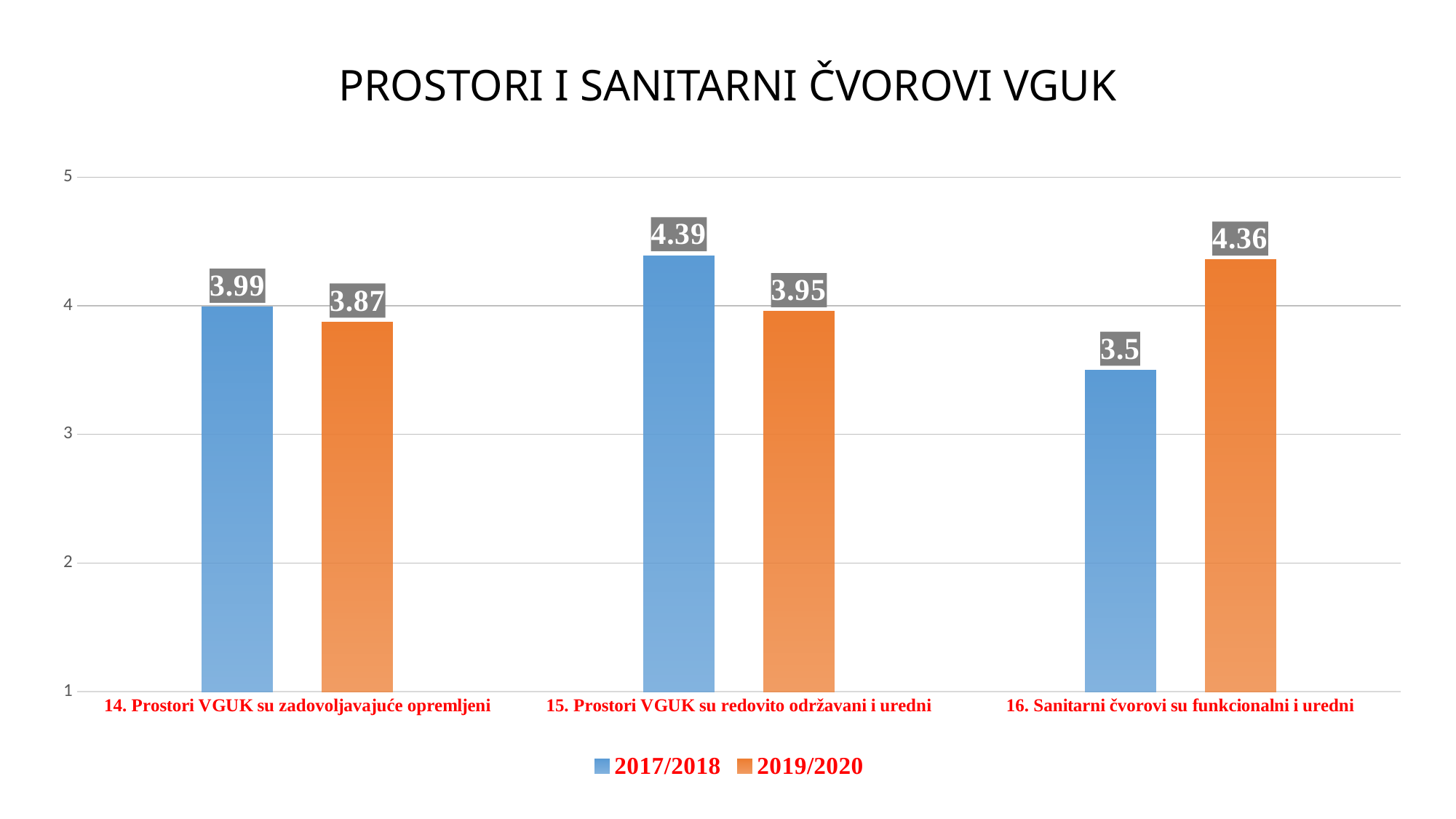
Which category has the highest 2017/2018 value? 15. Prostori VGUK su redovito održavani i uredni Which category has the lowest 2019/2020 value? 14. Prostori VGUK su zadovoljavajuće opremljeni What is the 2019/2020 value for '15. Prostori VGUK su redovito održavani i uredni'? 3.95 What is the 2017/2018 value for '14. Prostori VGUK su zadovoljavajuće opremljeni'? 3.99 What is the 2019/2020 value for '16. Sanitarni čvorovi su funkcionalni i uredni'? 4.36 What kind of chart is shown on the slide? Bar chart How many series does the legend list? 2 What is the difference between the 2019/2020 and 2017/2018 values for '16. Sanitarni čvorovi su funkcionalni i uredni'? 0.86 What is the title of the chart? PROSTORI I SANITARNI ČVOROVI VGUK For '15. Prostori VGUK su redovito održavani i uredni', which series has the larger value, 2017/2018 or 2019/2020? 2017/2018 Which category has the lowest 2017/2018 value? 16. Sanitarni čvorovi su funkcionalni i uredni How many categories are shown on the x axis? 3